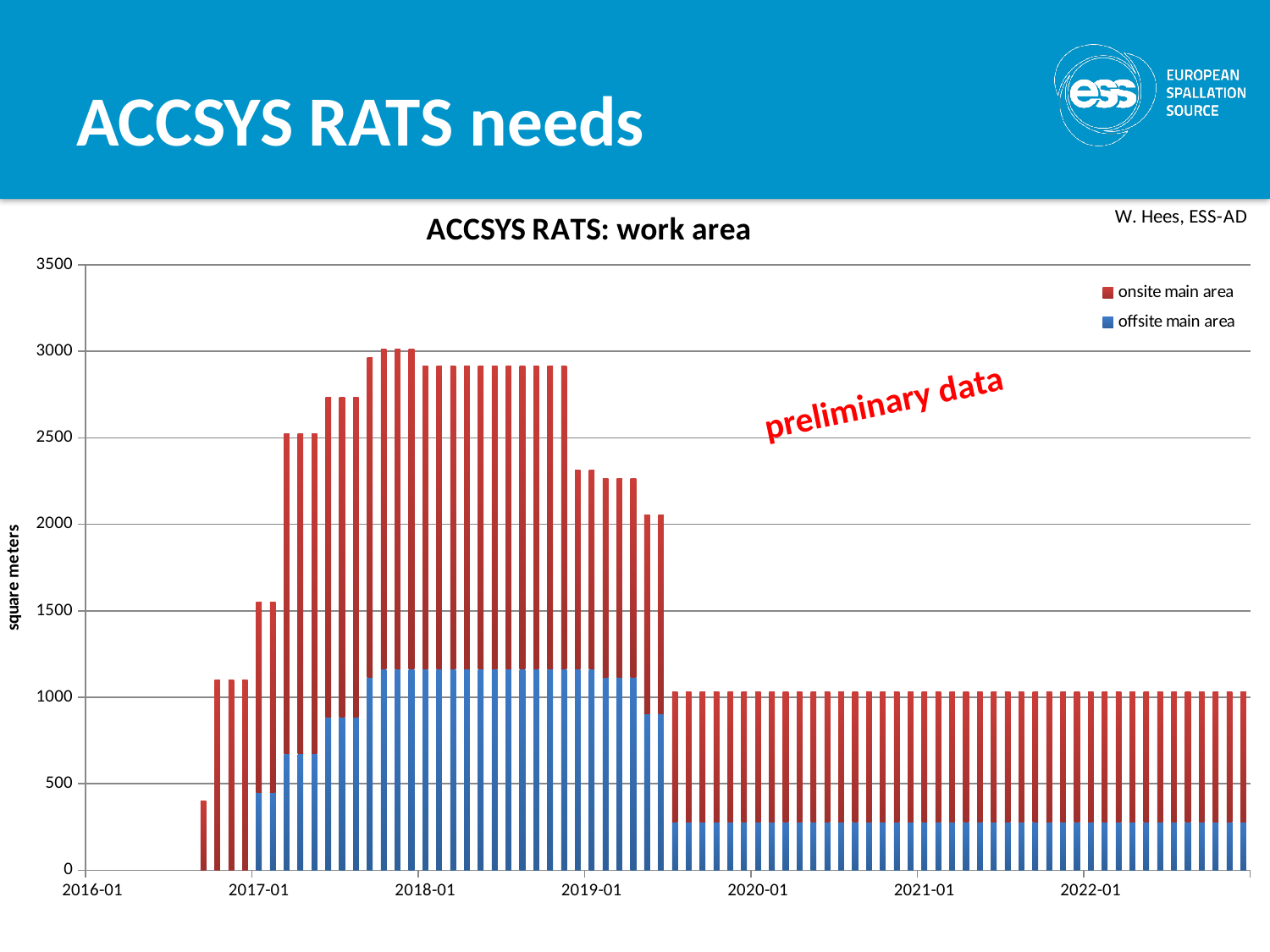
Is the total work area at 2020-01 greater or less than 1500? less Is the offsite main area at 2021-01 greater or less than 500? less Between 2016-01 and 2018-01, does the total work area rise or fall? rise Which series is shown in red? onsite main area Which is larger, the total work area at 2018-01 or at 2021-01? 2018-01 Is the offsite main area at 2018-01 greater or less than 1000? greater What kind of chart is shown on the slide? Stacked bar chart What is the label on the vertical axis? square meters Between 2019-01 and 2020-01, does the total work area rise or fall? fall How many series does the legend list? 2